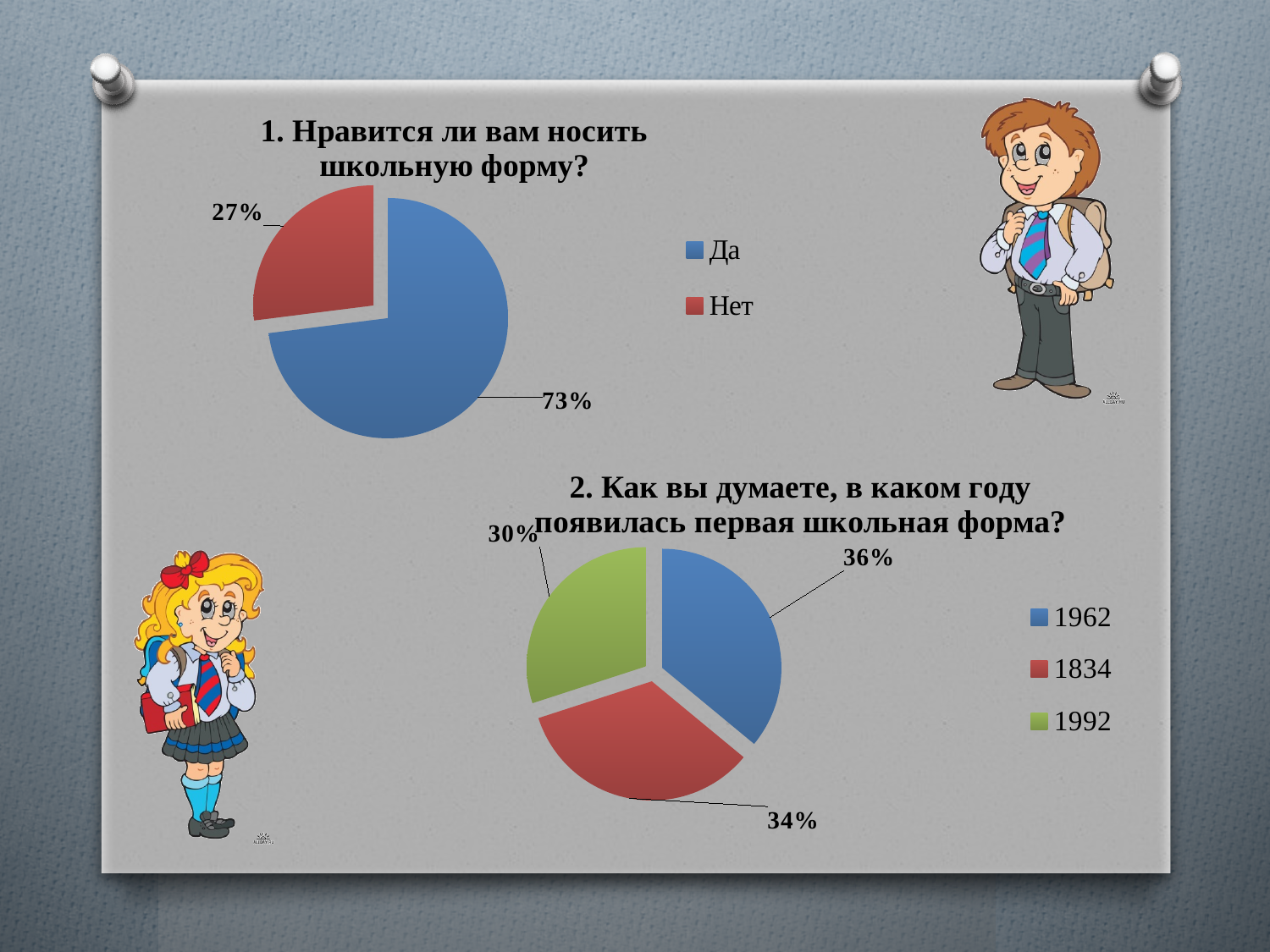
How many slices does the bottom pie chart have? 3 In the chart titled "1. Нравится ли вам носить школьную форму?", which answer has the larger slice? Да In the chart titled "1. Нравится ли вам носить школьную форму?", what is the difference in percentage points between "Да" and "Нет"? 46 In the chart titled "2. Как вы думаете, в каком году появилась первая школьная форма?", what share is labelled for 1834? 34% In the chart titled "1. Нравится ли вам носить школьную форму?", what share of the pie is labelled "Да"? 73% In the chart titled "1. Нравится ли вам носить школьную форму?", what share of the pie is labelled "Нет"? 27% In the chart titled "2. Как вы думаете, в каком году появилась первая школьная форма?", which year has the smallest slice? 1992 In the chart titled "2. Как вы думаете, в каком году появилась первая школьная форма?", what share is labelled for 1992? 30% In the bottom chart, what colour is the slice for 1992? Green In the chart titled "2. Как вы думаете, в каком году появилась первая школьная форма?", what share is labelled for 1962? 36% How many entries does the legend of the top chart list? 2 What kind of chart is the top chart on the slide? Pie chart